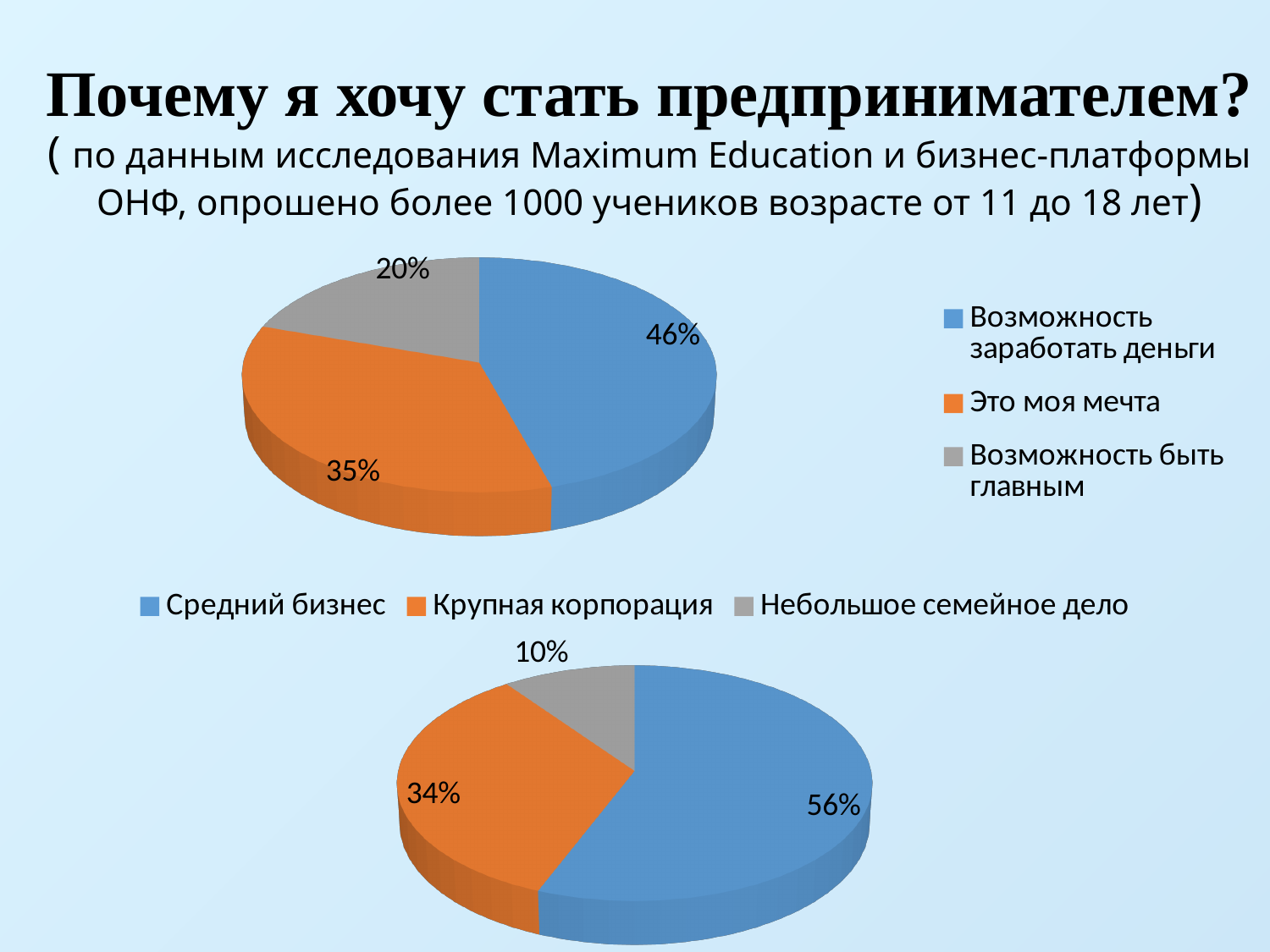
In the top pie chart, what share is labelled for 'Это моя мечта'? 35% In the bottom pie chart, what is the difference between the shares for 'Средний бизнес' and 'Крупная корпорация'? 22% In the top pie chart, what share is labelled for 'Возможность быть главным'? 20% In the bottom pie chart, what share is labelled for 'Крупная корпорация'? 34% In the bottom pie chart, which category has the smallest slice? Небольшое семейное дело In the top pie chart, which category has the largest slice? Возможность заработать деньги In the top pie chart, what is the difference between the shares for 'Возможность заработать деньги' and 'Это моя мечта'? 11% In the bottom pie chart, what share is labelled for 'Небольшое семейное дело'? 10% In the bottom pie chart, what share is labelled for 'Средний бизнес'? 56% In the top pie chart, what share is labelled for 'Возможность заработать деньги'? 46% In the top pie chart, which category has the smallest slice? Возможность быть главным How many categories does the legend of the bottom pie chart list? 3